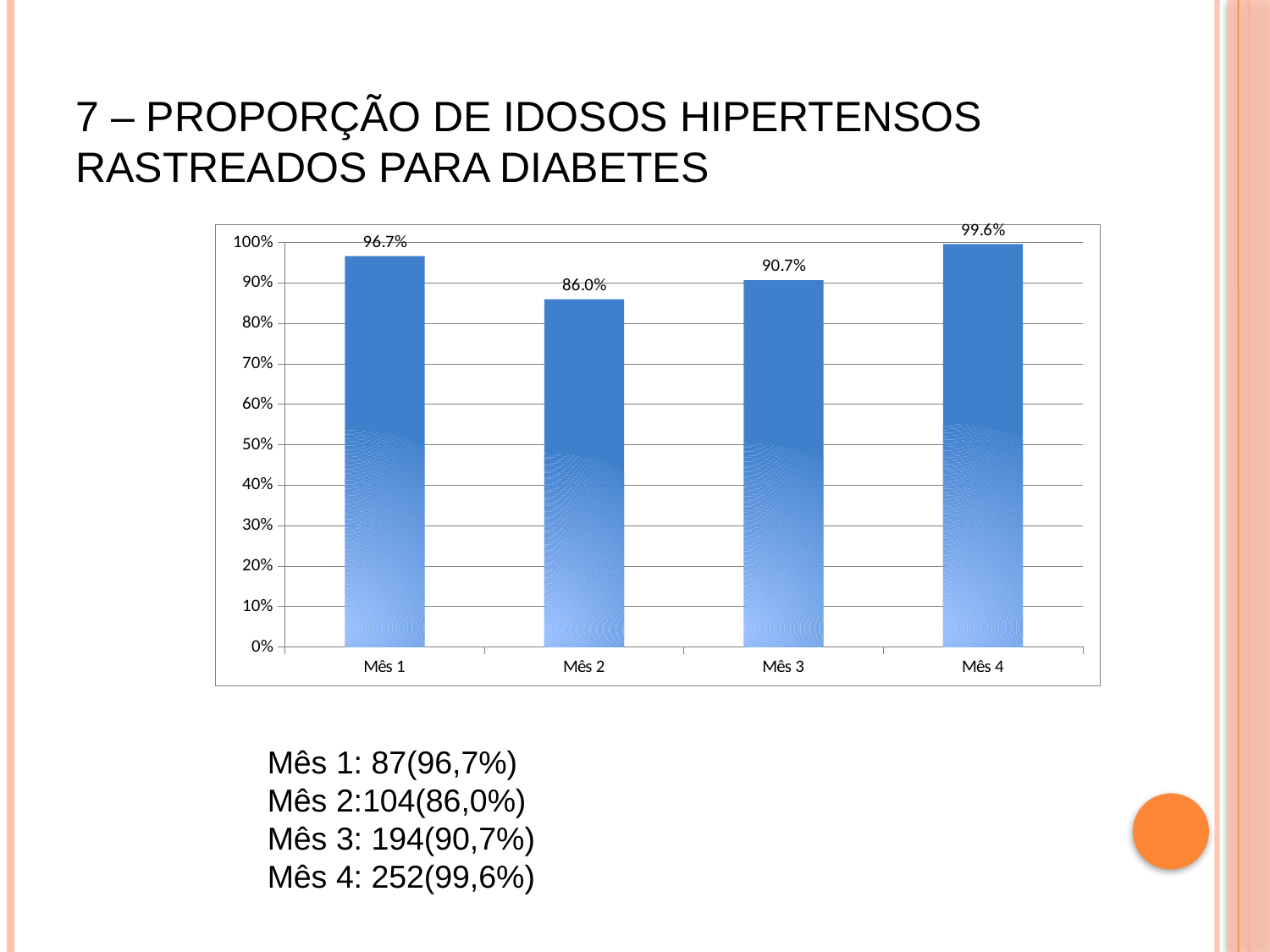
What is the value for Mês 1? 96.7% Is the value for Mês 2 greater or less than 90%? less Which is larger, the value for Mês 1 or the value for Mês 3? Mês 1 How many months are shown on the x axis? 4 What is the difference between the values for Mês 4 and Mês 2? 13.6% What kind of chart is shown on the slide? bar chart What is the difference between the values for Mês 1 and Mês 3? 6.0% What is the value for Mês 3? 90.7% What is the value for Mês 4? 99.6% Which month has the lowest value? Mês 2 Which month has the highest value? Mês 4 What is the value for Mês 2? 86.0%